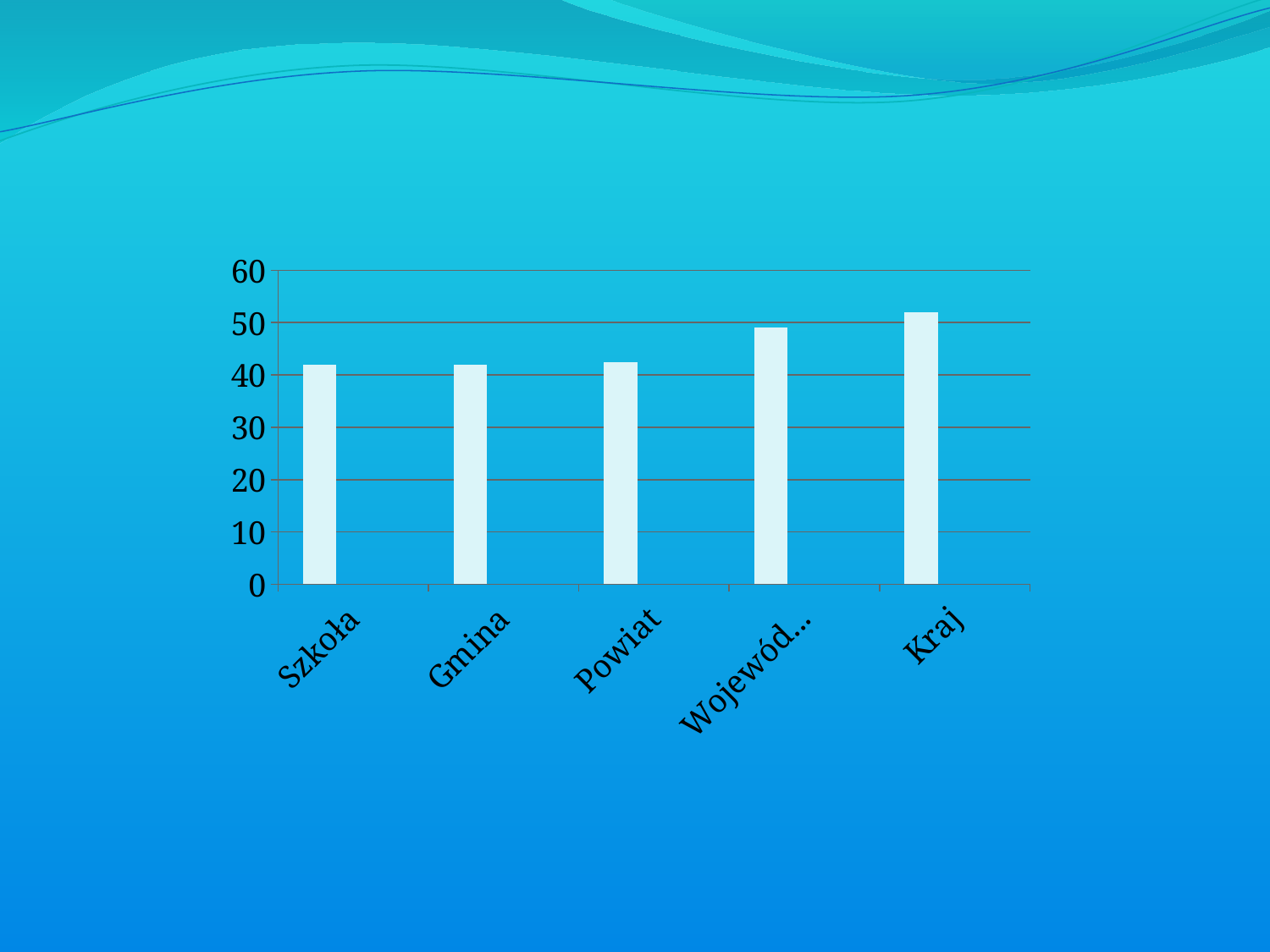
Is the value for Powiat greater or less than 50? less What kind of chart is shown on the slide? bar chart How many categories are shown on the x axis of the chart? 5 Which category has the highest bar in the chart? Kraj Which is larger, the value for Wojewód... or the value for Gmina? Wojewód... Is the value for Gmina greater or less than 40? greater Is the value for Szkoła greater or less than 50? less Which is larger, the value for Kraj or the value for Szkoła? Kraj What is the highest value shown on the vertical axis of the chart? 60 Do the bar values generally rise or fall from left to right along the x axis? rise